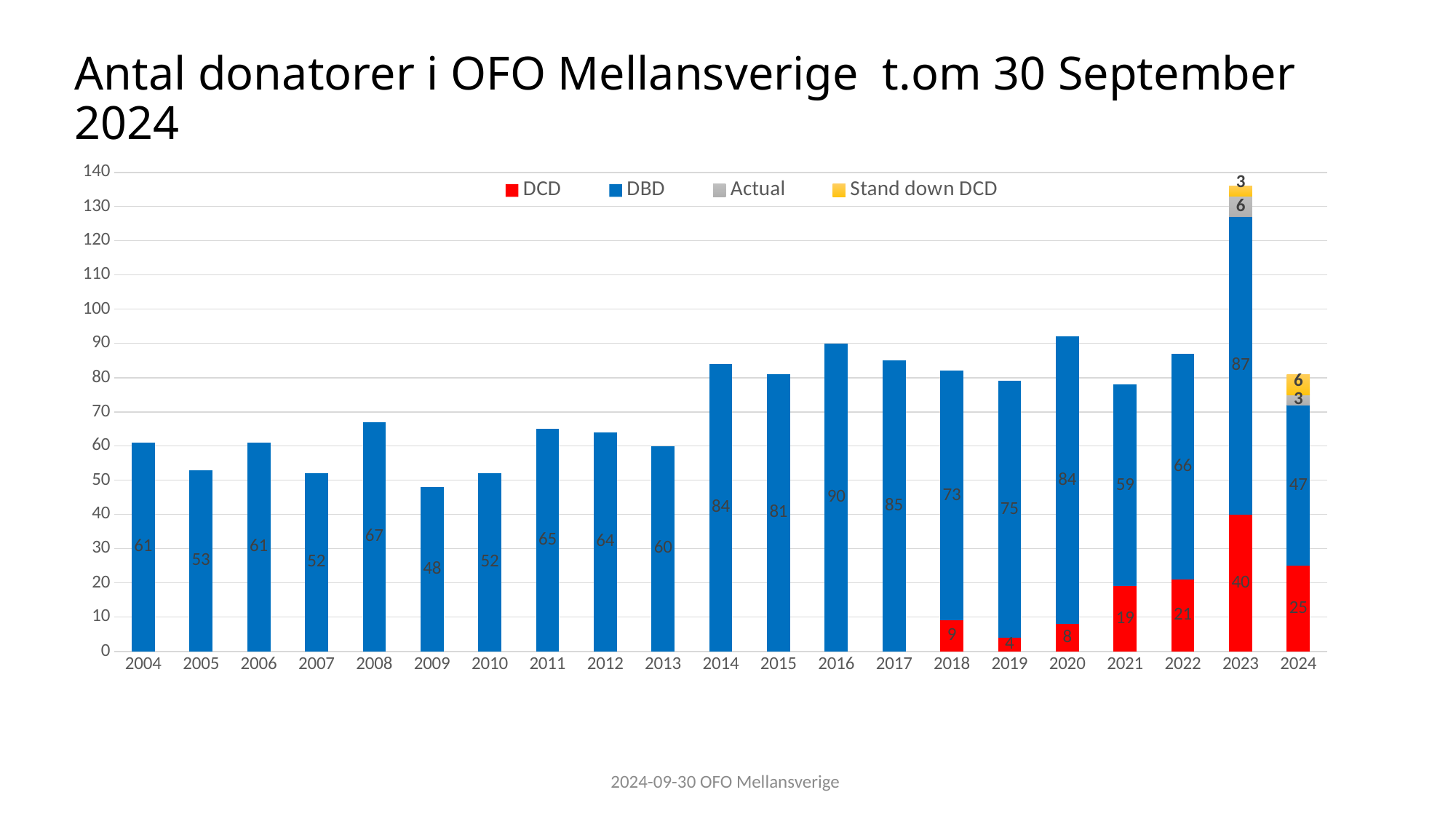
What is the DCD value for 2023? 40 What is the DBD value for 2016? 90 Which year has the highest DCD value? 2023 What type of chart is shown on the slide? stacked bar chart How many series does the legend list? 4 What is the total of the stacked bar for 2024? 81 Which is larger, the DCD value for 2022 or the DCD value for 2019? 2022 What is the Actual value for 2024? 3 What is the difference between the DBD values for 2014 and 2021? 25 Which year has the lowest DBD value? 2024 How many years are shown on the x axis? 21 What is the total of the stacked bar for 2023? 136